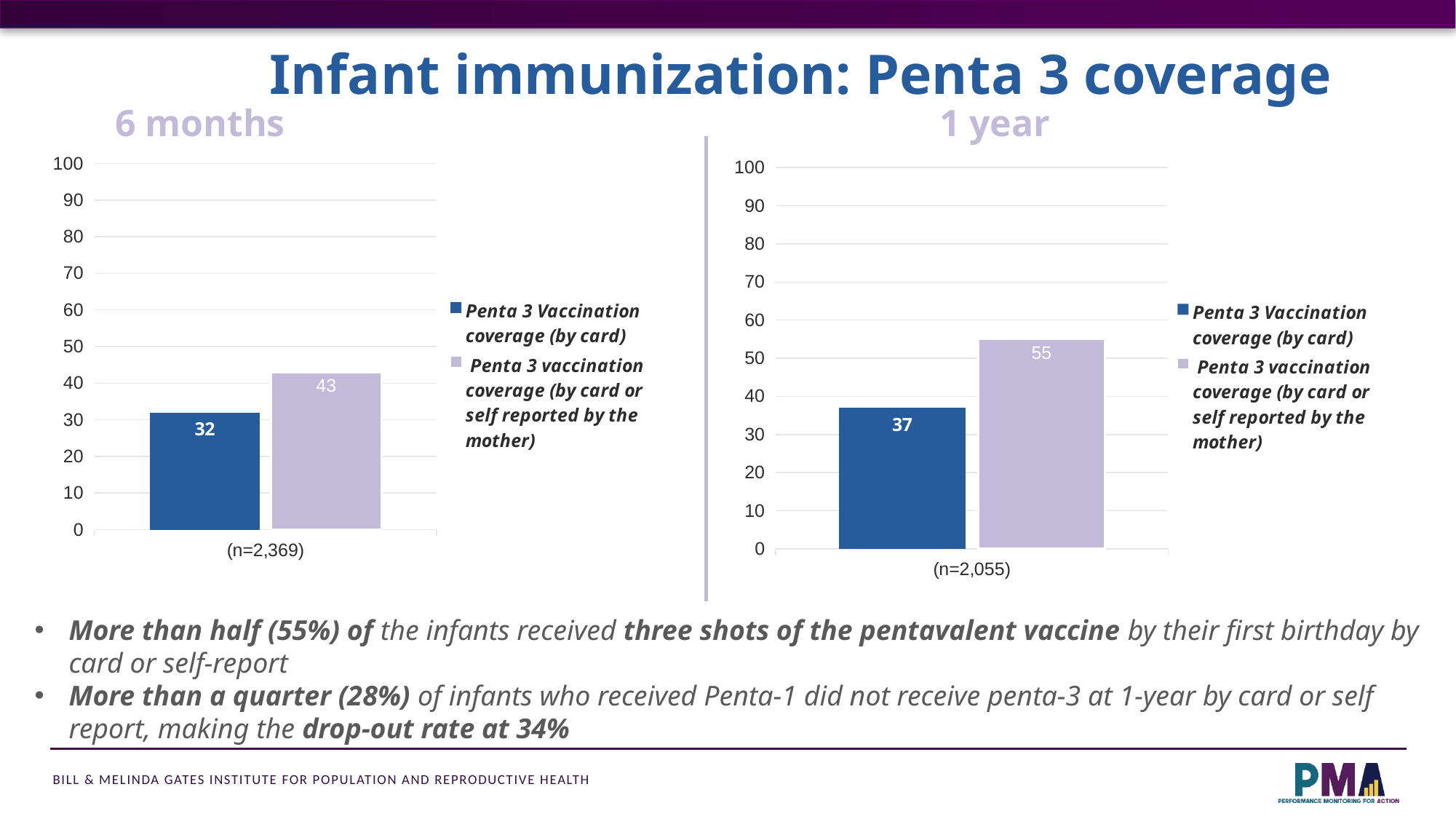
What kind of chart is the 1 year chart? bar chart In the 6 months chart, is the value for Penta 3 Vaccination coverage (by card) greater or less than 40? less In the 1 year chart, is the value for Penta 3 vaccination coverage (by card or self reported by the mother) greater or less than 50? greater What sample size is shown on the x axis of the 1 year chart? (n=2,055) In the 1 year chart, which series has the higher value? Penta 3 vaccination coverage (by card or self reported by the mother) In the 1 year chart, what is the value for Penta 3 vaccination coverage (by card or self reported by the mother)? 55 In the 6 months chart, what is the value for Penta 3 Vaccination coverage (by card)? 32 In the 6 months chart, what is the value for Penta 3 vaccination coverage (by card or self reported by the mother)? 43 How many series does the legend of the 6 months chart list? 2 In the 6 months chart, what is the difference between coverage by card or self report and coverage by card? 11 In the 1 year chart, what is the difference between coverage by card or self report and coverage by card? 18 In the 1 year chart, what is the value for Penta 3 Vaccination coverage (by card)? 37